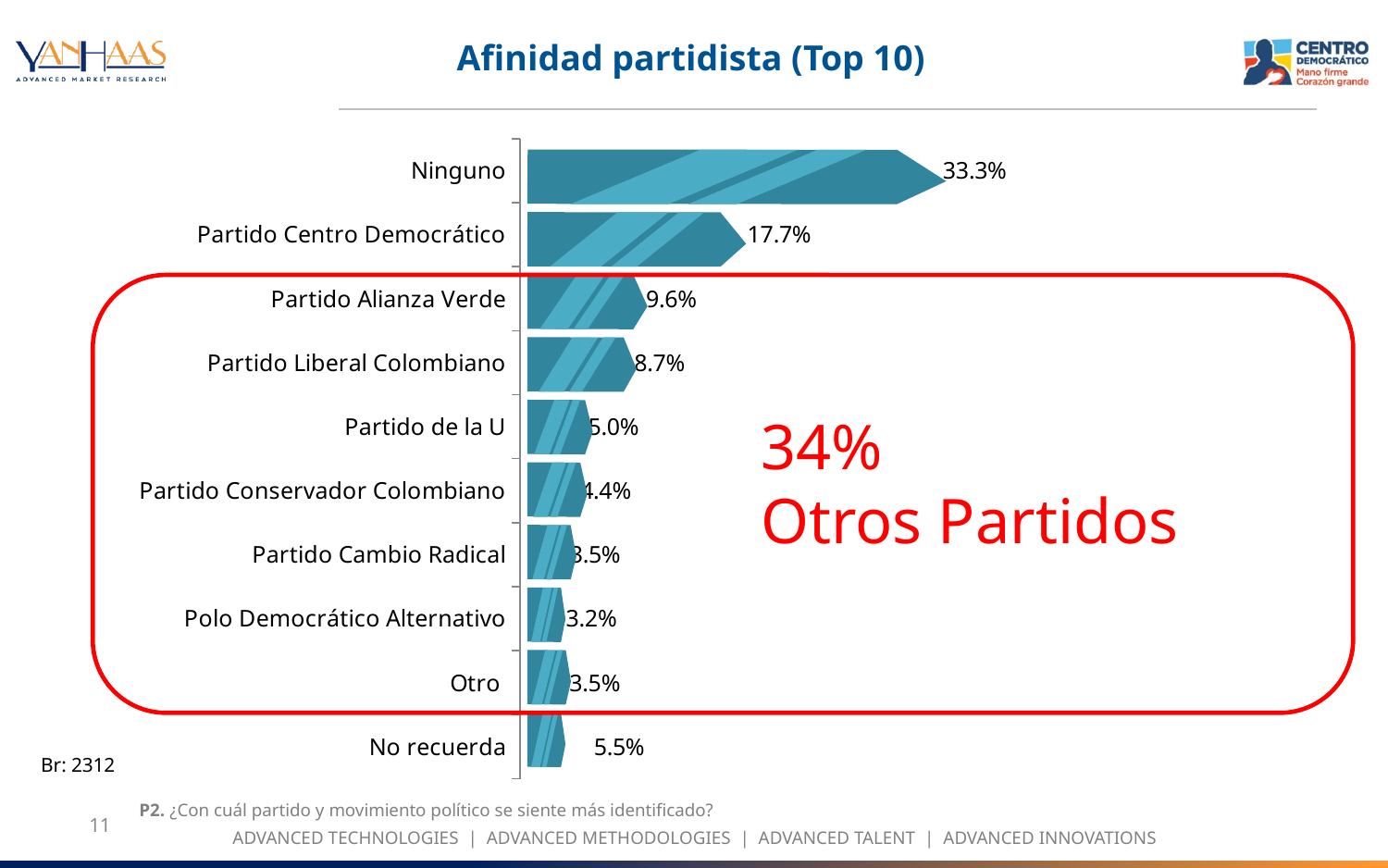
What kind of chart is shown on the slide? bar chart Which category has the highest value? Ninguno What is the value for No recuerda? 5.5% How many categories are shown in the chart? 10 What is the title of the chart? Afinidad partidista (Top 10) What percentage is shown in red inside the outlined box for 'Otros Partidos'? 34% Which category has the lowest value? Polo Democrático Alternativo What is the value for Partido Centro Democrático? 17.7% Which is larger, the value for Partido Alianza Verde or the value for Partido Liberal Colombiano? Partido Alianza Verde What is the difference between the values for Ninguno and Partido Centro Democrático? 15.6% What is the value for Partido Liberal Colombiano? 8.7% What is the value for Ninguno? 33.3%